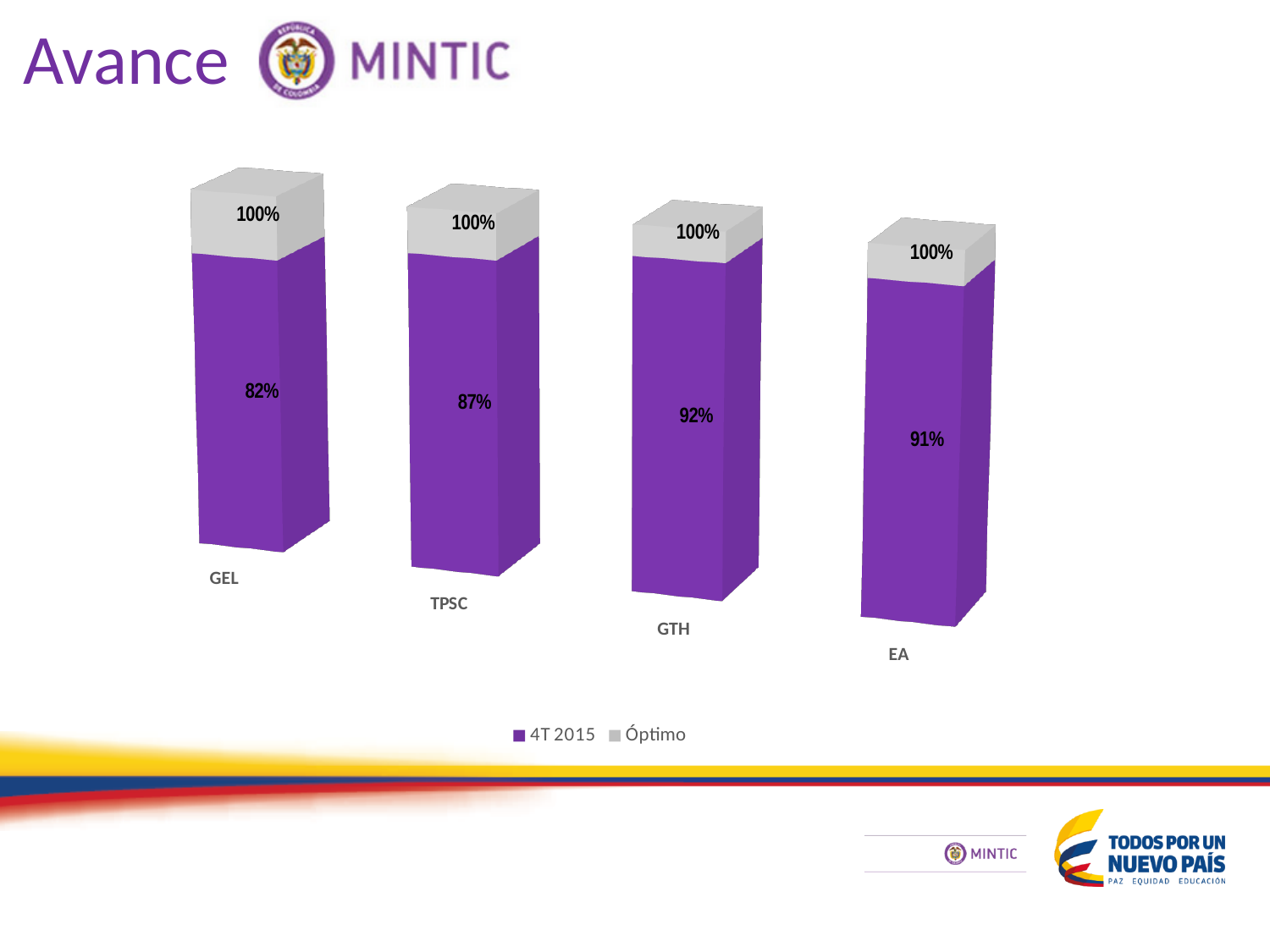
What is the Óptimo value for GEL? 100% What is the 4T 2015 value for EA? 91% Which category has the lowest 4T 2015 value? GEL How many categories are shown on the x axis? 4 How many series does the legend list? 2 What is the 4T 2015 value for GTH? 92% What is the 4T 2015 value for TPSC? 87% Which category has the highest 4T 2015 value? GTH What is the difference between the 4T 2015 values for GTH and GEL? 10% What is the 4T 2015 value for GEL? 82% What kind of chart is shown on the slide? Bar chart What is the difference between the Óptimo value and the 4T 2015 value for TPSC? 13%